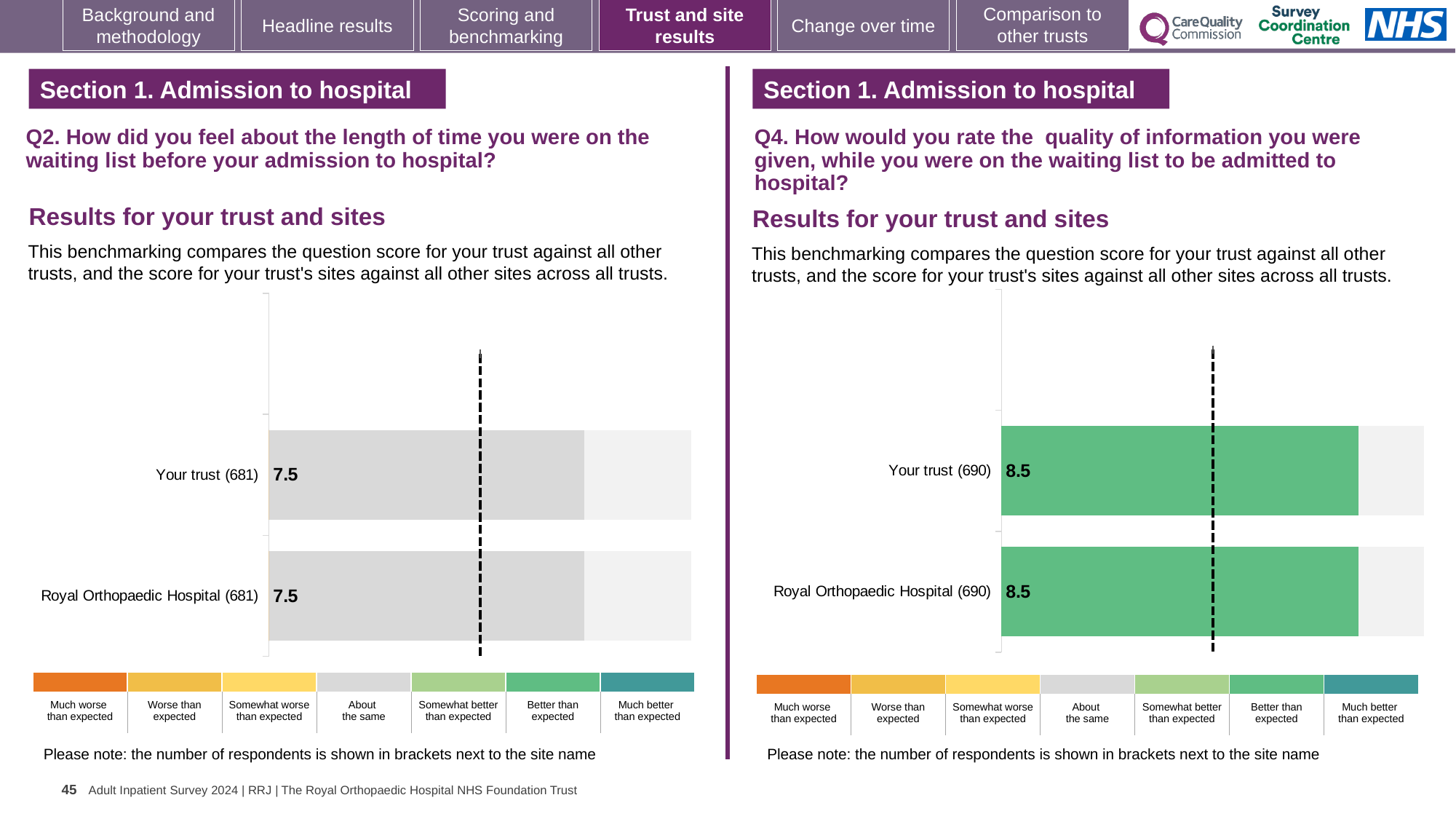
Is the score for Your trust on the Q4 chart (right) larger or smaller than the score for Your trust on the Q2 chart (left)? Larger On the Q2 chart (left), what is the score for Royal Orthopaedic Hospital? 7.5 On the Q4 chart (right), what is the score for Royal Orthopaedic Hospital? 8.5 On the Q2 chart (left), how many respondents are shown in brackets for Your trust? 681 On the Q4 chart (right), what is the difference between the score for Your trust and the score for Royal Orthopaedic Hospital? 0 What kind of chart is the Q2 chart (left)? Bar chart On the Q4 chart (right), how many respondents are shown in brackets for Royal Orthopaedic Hospital? 690 On the Q2 chart (left), what is the score for Your trust? 7.5 How many bars are plotted on the Q2 chart (left)? 2 On the Q2 chart (left), what is the difference between the score for Your trust and the score for Royal Orthopaedic Hospital? 0 On the Q4 chart (right), what is the score for Your trust? 8.5 How many bars are plotted on the Q4 chart (right)? 2